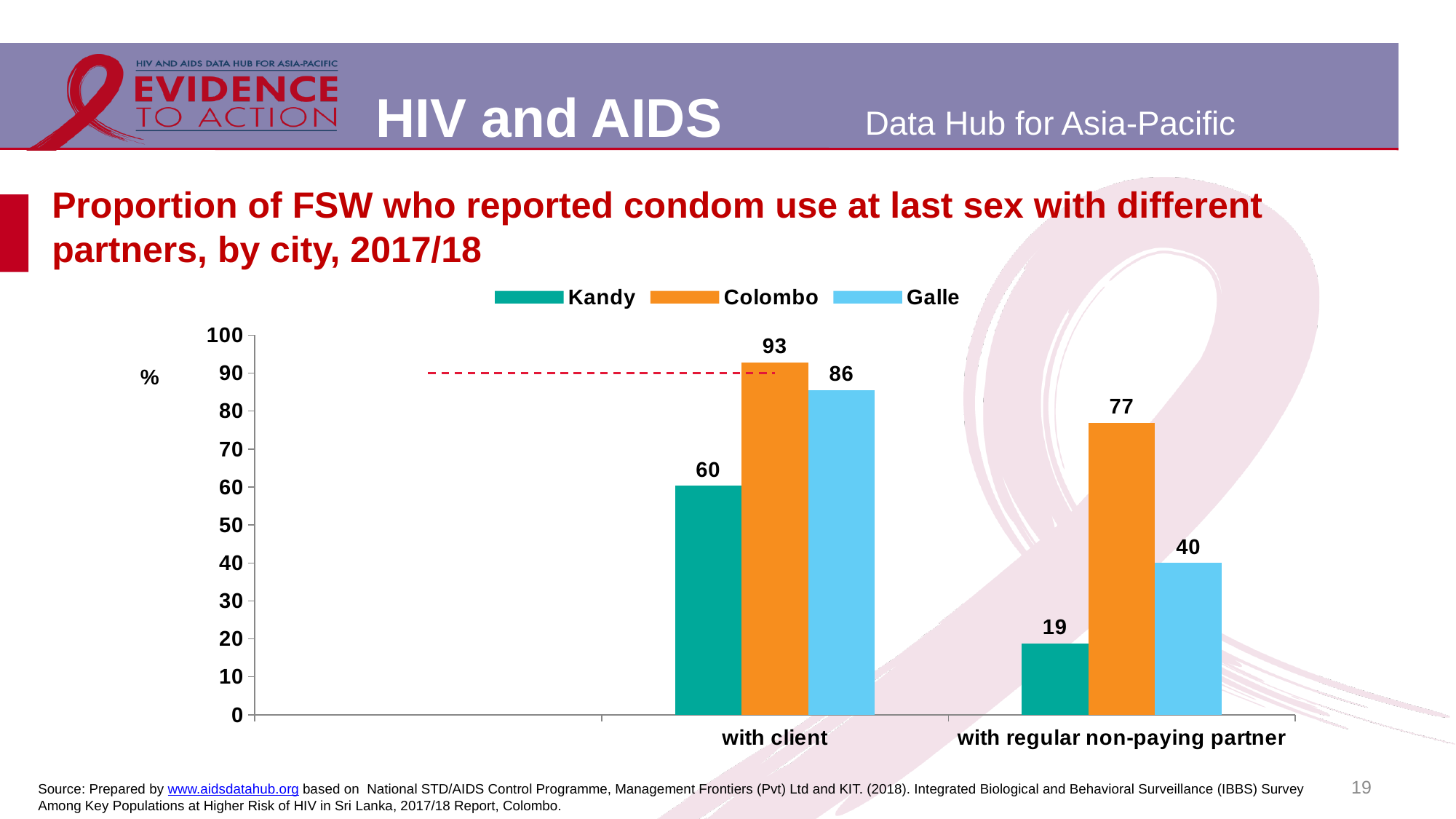
Is the Colombo value for 'with client' greater or less than 90? greater What kind of chart is shown on the slide? Bar chart Which colour represents Colombo in the chart? Orange Which city has the lowest value in the 'with regular non-paying partner' category? Kandy What is the difference between the Colombo and Kandy values in the 'with client' category? 33 Which is larger: the Galle value for 'with regular non-paying partner' or the Kandy value for 'with regular non-paying partner'? Galle What is the difference between the Galle values for 'with client' and 'with regular non-paying partner'? 46 What is the value for Galle in the 'with client' category? 86 Which city has the highest value in the 'with client' category? Colombo What is the value for Colombo in the 'with regular non-paying partner' category? 77 What is the value for Kandy in the 'with client' category? 60 How many series does the legend list? 3